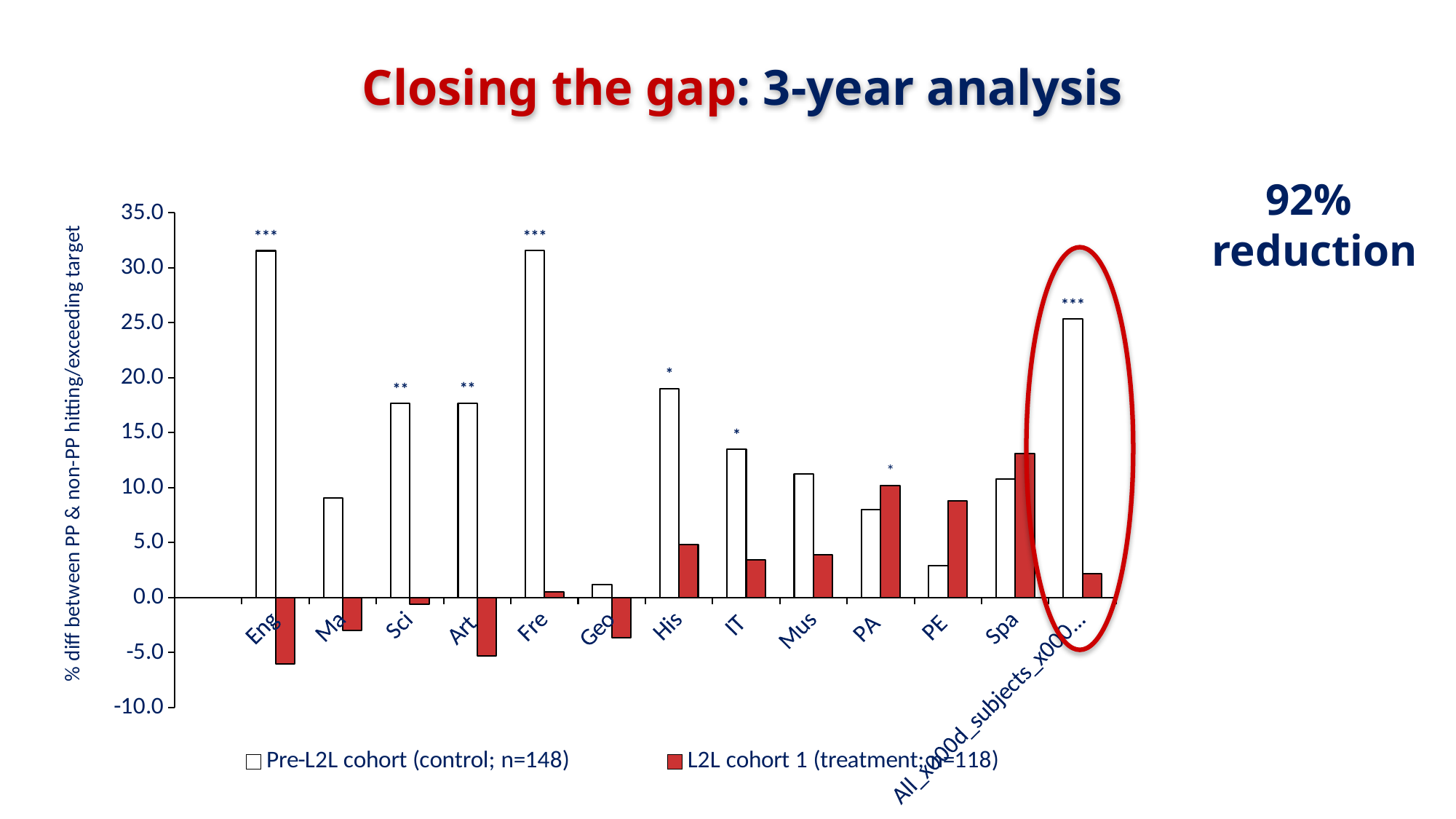
Which category has the highest L2L cohort 1 (treatment) value? Spa How many series does the legend list? 2 What kind of chart is shown on the slide? bar chart Is the Pre-L2L cohort (control) value for Geo greater or less than 5.0? less What is the title of the chart's slide? Closing the gap: 3-year analysis Is the L2L cohort 1 (treatment) value for Spa greater or less than 10.0? greater How many categories are shown along the x axis? 13 For PE, which series has the larger value: Pre-L2L cohort (control) or L2L cohort 1 (treatment)? L2L cohort 1 (treatment) Which category has the lowest Pre-L2L cohort (control) value? Geo Is the L2L cohort 1 (treatment) value for Eng greater or less than 0.0? less